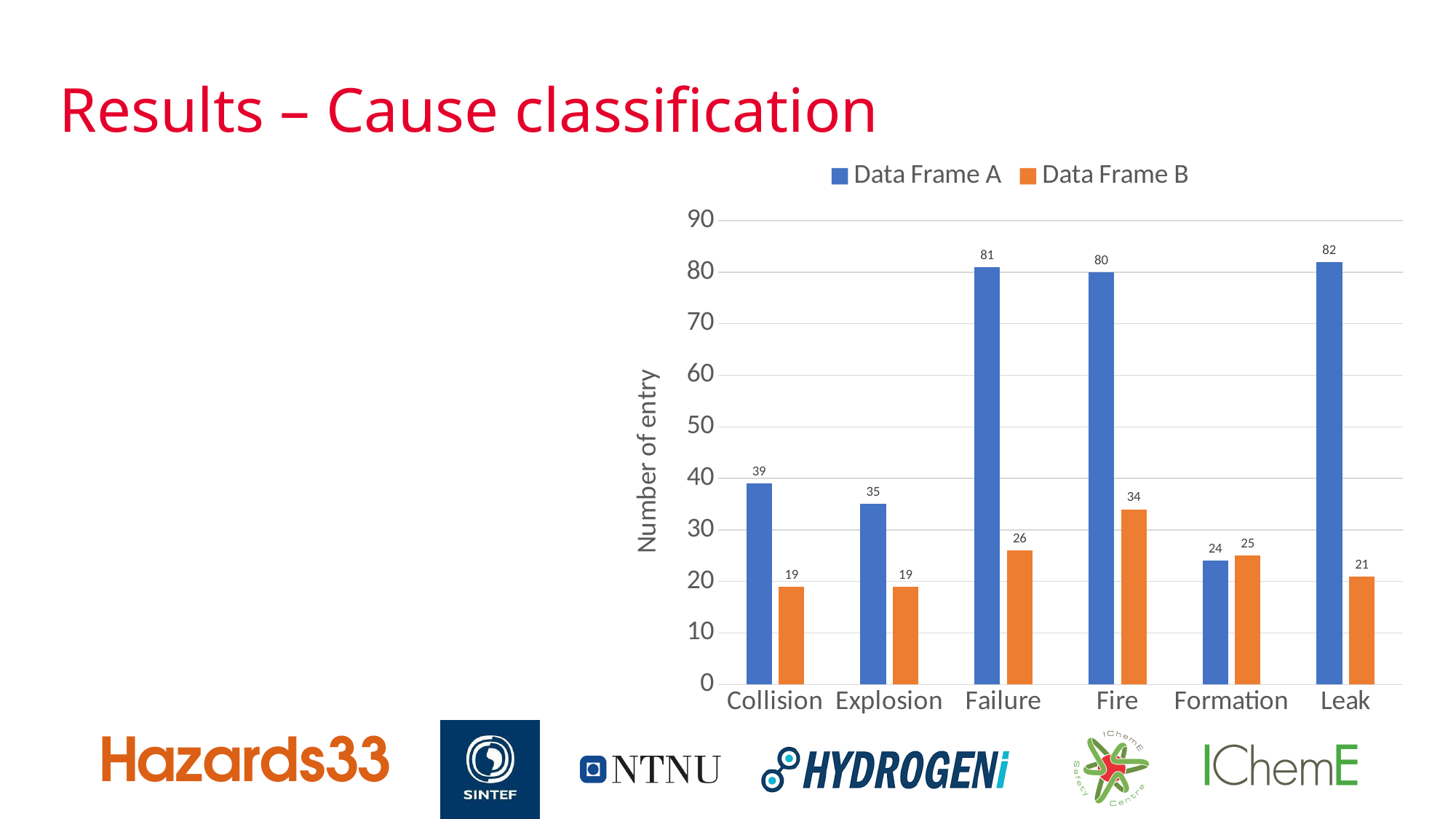
How many series does the legend list? 2 For Formation, which is larger: Data Frame A or Data Frame B? Data Frame B What is the Data Frame A value for Failure? 81 Which category has the highest Data Frame B value? Fire What kind of chart is shown on the slide? Bar chart What is the Data Frame B value for Fire? 34 What is the Data Frame A value for Collision? 39 What is the label of the vertical axis? Number of entry Which category has the lowest Data Frame A value? Formation Which category has the highest Data Frame A value? Leak How many categories are shown on the x axis? 6 What is the difference between the Data Frame A and Data Frame B values for Leak? 61